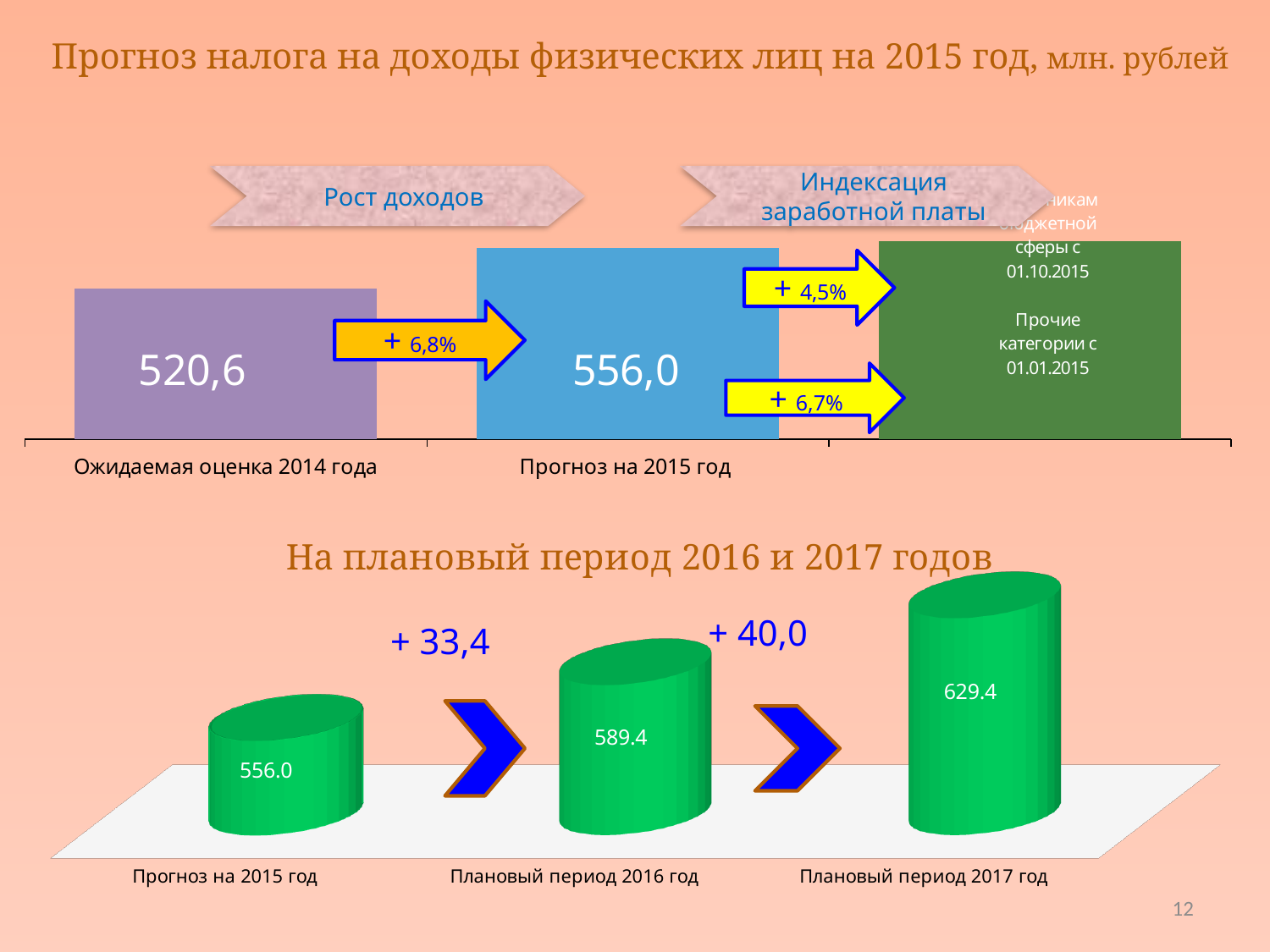
In the bottom chart, what is the value for Плановый период 2017 год? 629.4 In the bottom chart, do the values rise or fall from left to right? rise In the bottom chart, what is the value for Прогноз на 2015 год? 556.0 In the bottom chart, which category has the highest value? Плановый период 2017 год In the bottom chart, what is the value for Плановый период 2016 год? 589.4 In the bottom chart, how many categories are shown? 3 In the top chart, what is the difference between the value for Прогноз на 2015 год and the value for Ожидаемая оценка 2014 года? 35,4 In the top chart, what is the value for Ожидаемая оценка 2014 года? 520,6 In the top chart, which is larger: the value for Ожидаемая оценка 2014 года or the value for Прогноз на 2015 год? Прогноз на 2015 год In the bottom chart, what is the difference between the value for Плановый период 2017 год and the value for Плановый период 2016 год? 40.0 In the top chart, what is the value for Прогноз на 2015 год? 556,0 In the bottom chart, which category has the lowest value? Прогноз на 2015 год